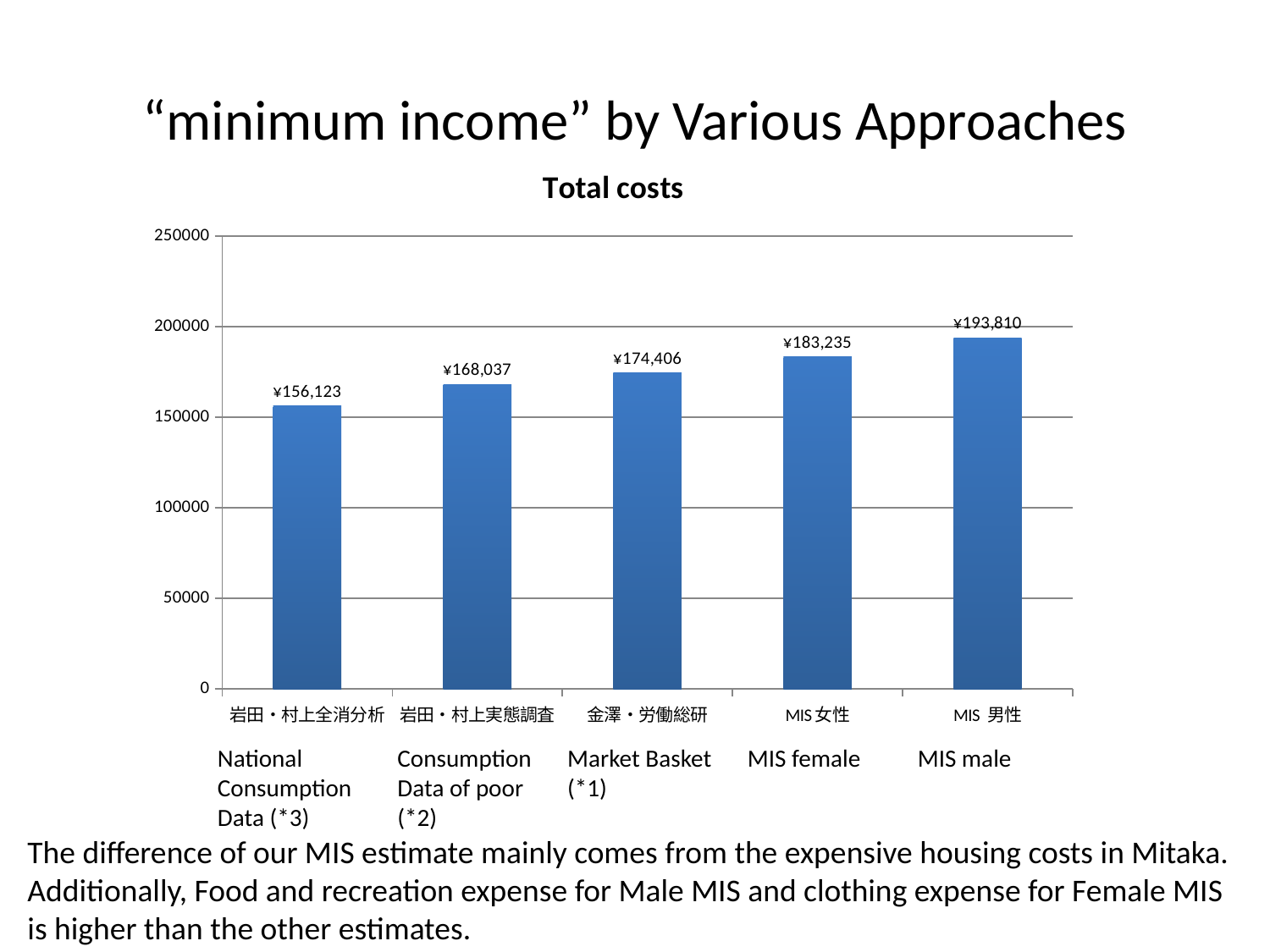
Which category has the highest total cost? MIS male Is the value for MIS female greater or less than 200000? less What is the value for MIS female in the Total costs chart? ¥183,235 Which category has the lowest total cost? National Consumption Data (*3) What is the value for National Consumption Data (*3) in the Total costs chart? ¥156,123 What is the difference between the Market Basket (*1) value and the Consumption Data of poor (*2) value? ¥6,369 What is the difference between the MIS male and MIS female values? ¥10,575 Which is larger, the value for Market Basket (*1) or the value for Consumption Data of poor (*2)? Market Basket (*1) What is the value for MIS male in the Total costs chart? ¥193,810 What is the value for Market Basket (*1) in the Total costs chart? ¥174,406 Do the values rise or fall from left to right across the categories? rise How many categories are shown in the Total costs chart? 5